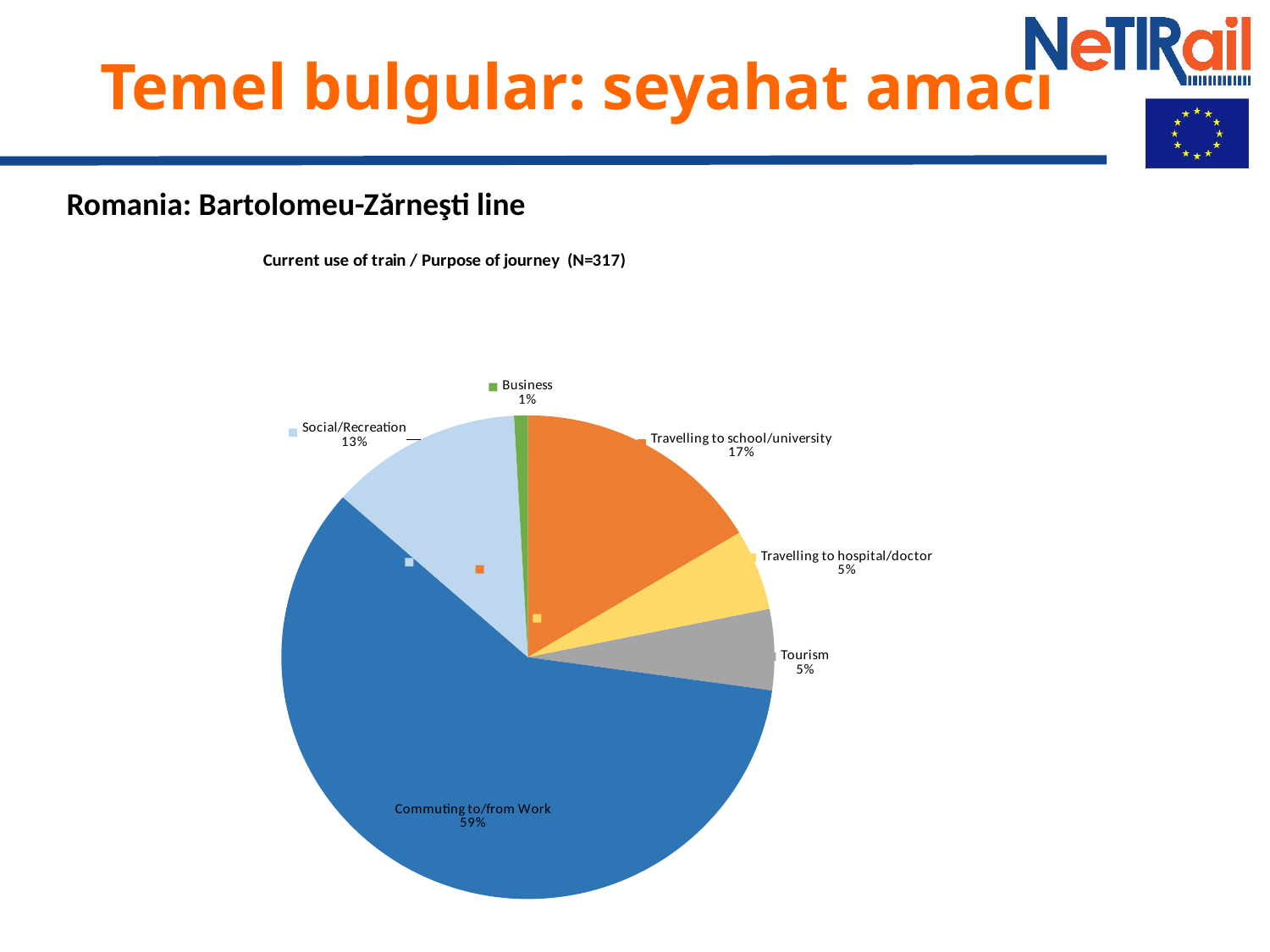
What share of journeys is for Travelling to school/university? 17% How many categories are shown in the pie chart? 6 What is the difference in percentage points between Travelling to school/university and Social/Recreation? 4 What kind of chart is shown on the slide? Pie chart Which purpose of journey has the largest share? Commuting to/from Work Which purpose of journey has the smallest share? Business Which is larger: the share for Social/Recreation or the share for Travelling to hospital/doctor? Social/Recreation What share of journeys is for Business? 1% What is the sample size (N) given in the chart title? 317 What share of journeys is for Tourism? 5% What share of journeys is for Social/Recreation? 13% What share of journeys is for Commuting to/from Work? 59%